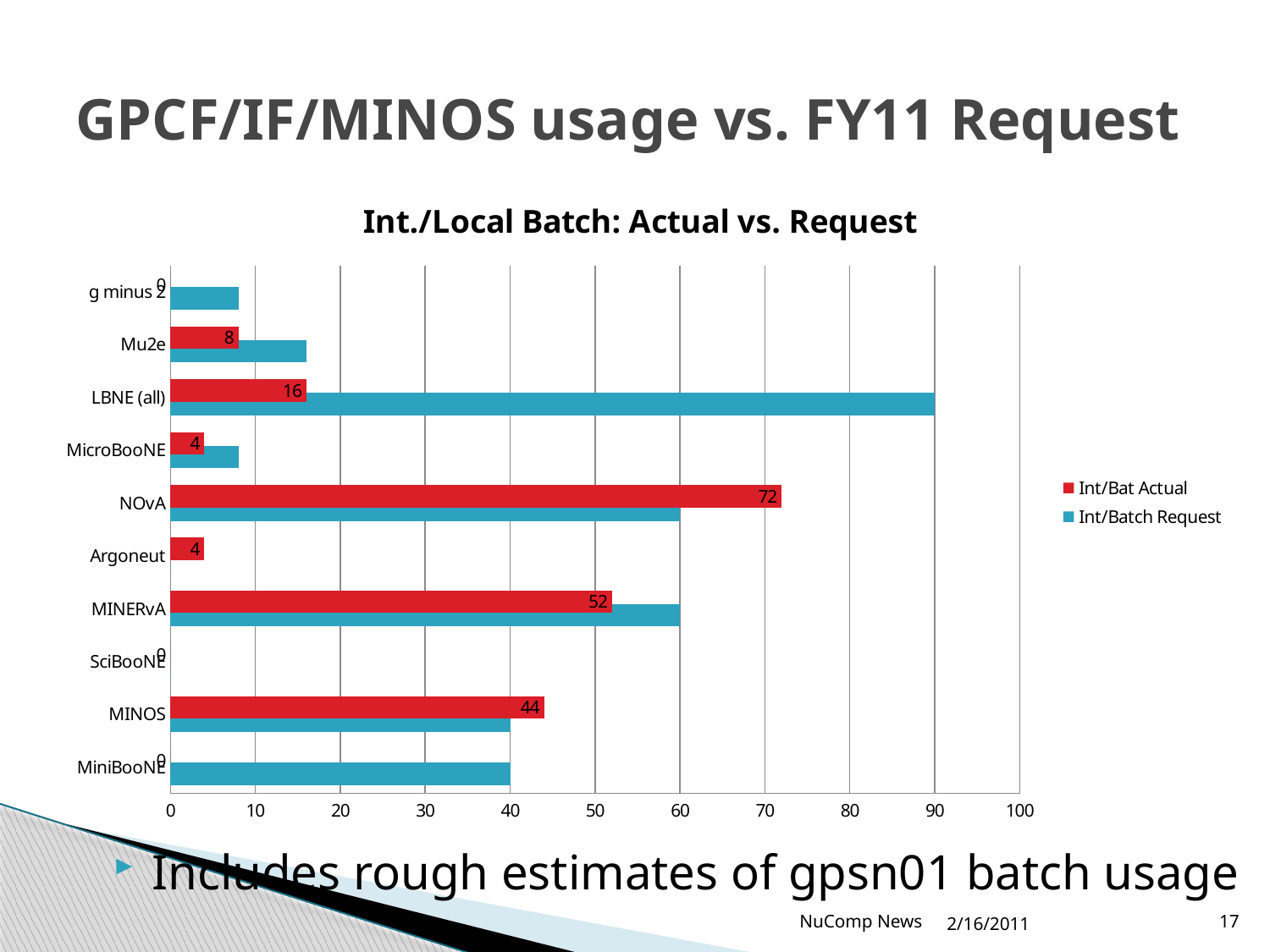
How many categories are shown on the chart? 10 What is the Int/Bat Actual value for MINOS? 44 Which has the larger Int/Bat Actual value, MINOS or MINERvA? MINERvA What is the difference between the Int/Bat Actual values for NOvA and MINERvA? 20 Which category has the highest Int/Bat Actual value? NOvA How many series does the legend list? 2 What is the Int/Bat Actual value for LBNE (all)? 16 What is the title of the chart? Int./Local Batch: Actual vs. Request What kind of chart is shown on the slide? bar chart What is the Int/Bat Actual value for NOvA? 72 Is the Int/Batch Request value for LBNE (all) greater or less than 80? greater Is the Int/Batch Request value for Mu2e greater or less than 20? less